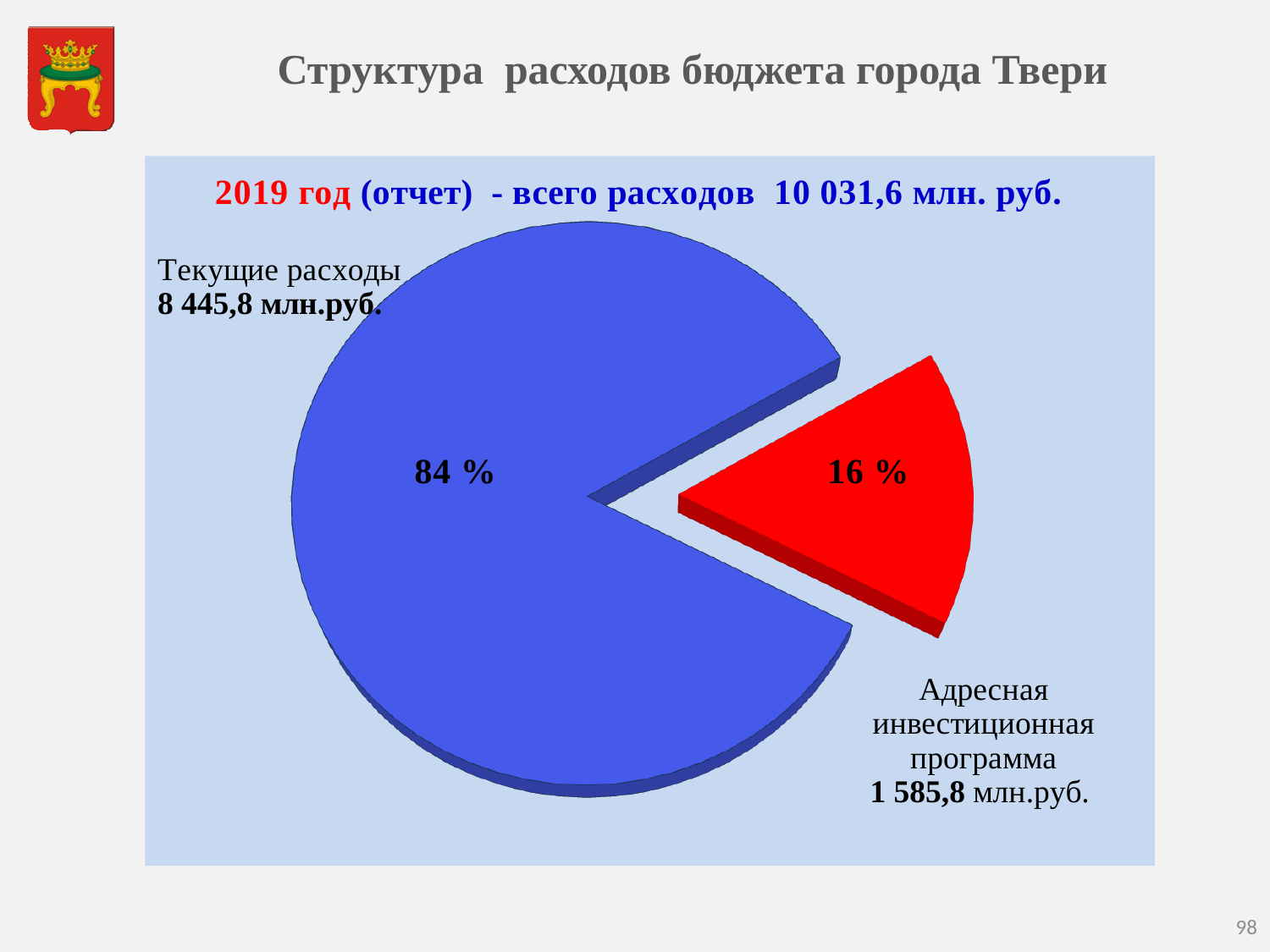
Which slice of the pie is the smallest? Адресная инвестиционная программа What share of the pie does "Адресная инвестиционная программа" take? 16 % What is the difference in percentage points between the "Текущие расходы" share and the "Адресная инвестиционная программа" share? 68 % What kind of chart is shown on the slide? pie chart What is the value shown for "Текущие расходы"? 8 445,8 млн.руб. How many slices does the pie chart have? 2 Which is larger, "Текущие расходы" or "Адресная инвестиционная программа"? Текущие расходы What total expenditure for 2019 is stated above the pie chart? 10 031,6 млн. руб. What share of the pie does "Текущие расходы" take? 84 % Which slice of the pie is the largest? Текущие расходы What is the value shown for "Адресная инвестиционная программа"? 1 585,8 млн.руб. What colour is the "Адресная инвестиционная программа" slice? red